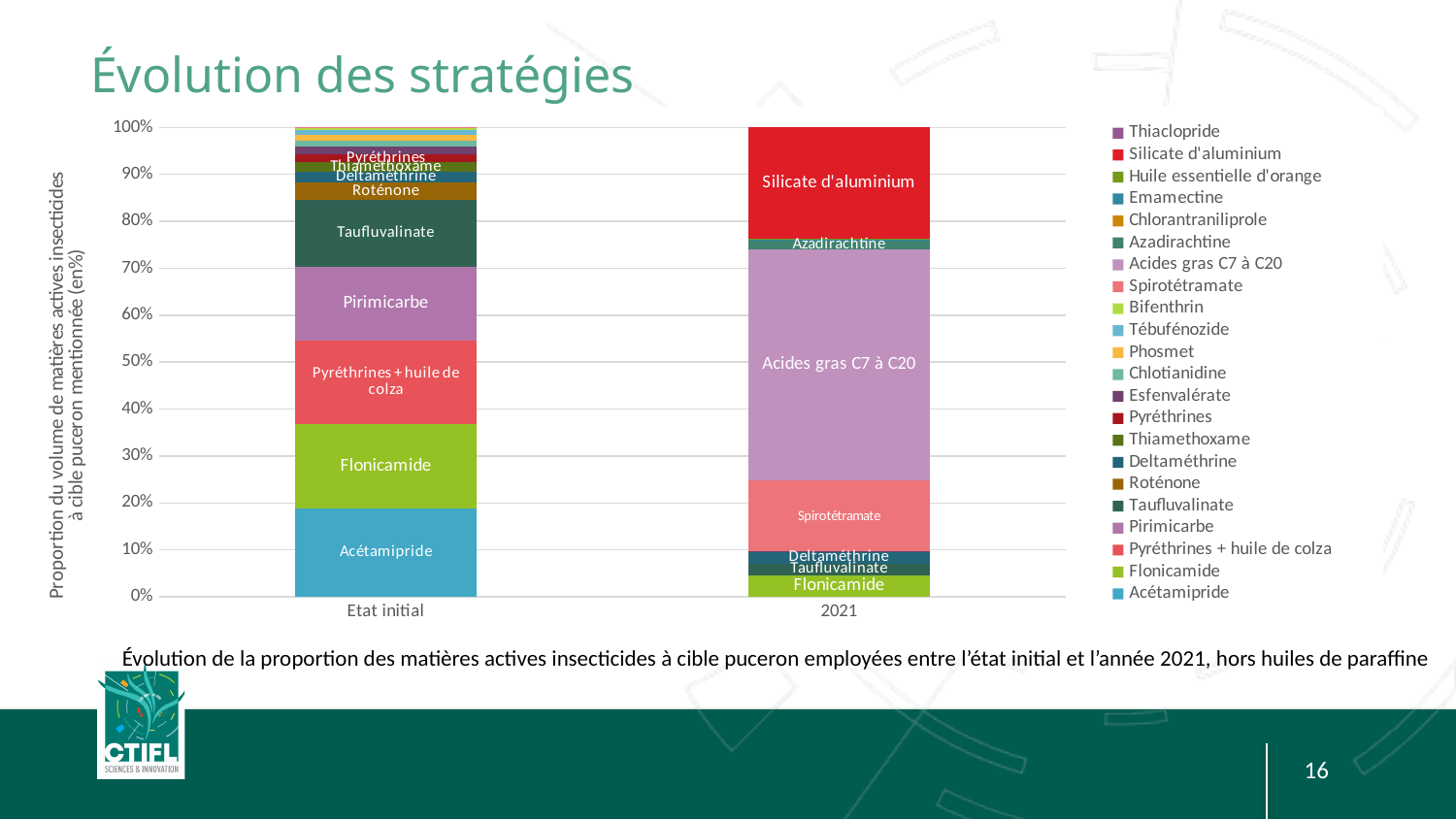
Is the share of Acétamipride in the Etat initial bar greater or less than 30%? less In the 2021 bar, which is larger: Acides gras C7 à C20 or Spirotétramate? Acides gras C7 à C20 What is the total height of the Etat initial stacked bar? 100% Is the share of Silicate d'aluminium in the 2021 bar greater or less than 10%? greater In the 2021 bar, which is larger: Silicate d'aluminium or Azadirachtine? Silicate d'aluminium What is the title of the chart slide? Évolution des stratégies Is the share of Acides gras C7 à C20 in the 2021 bar greater or less than 40%? greater What type of chart is shown on the slide? Stacked bar chart How many series does the chart legend list? 22 Which segment is the largest in the 2021 bar? Acides gras C7 à C20 Which segment is at the bottom of the Etat initial bar? Acétamipride How many categories are shown on the x axis of the chart? 2